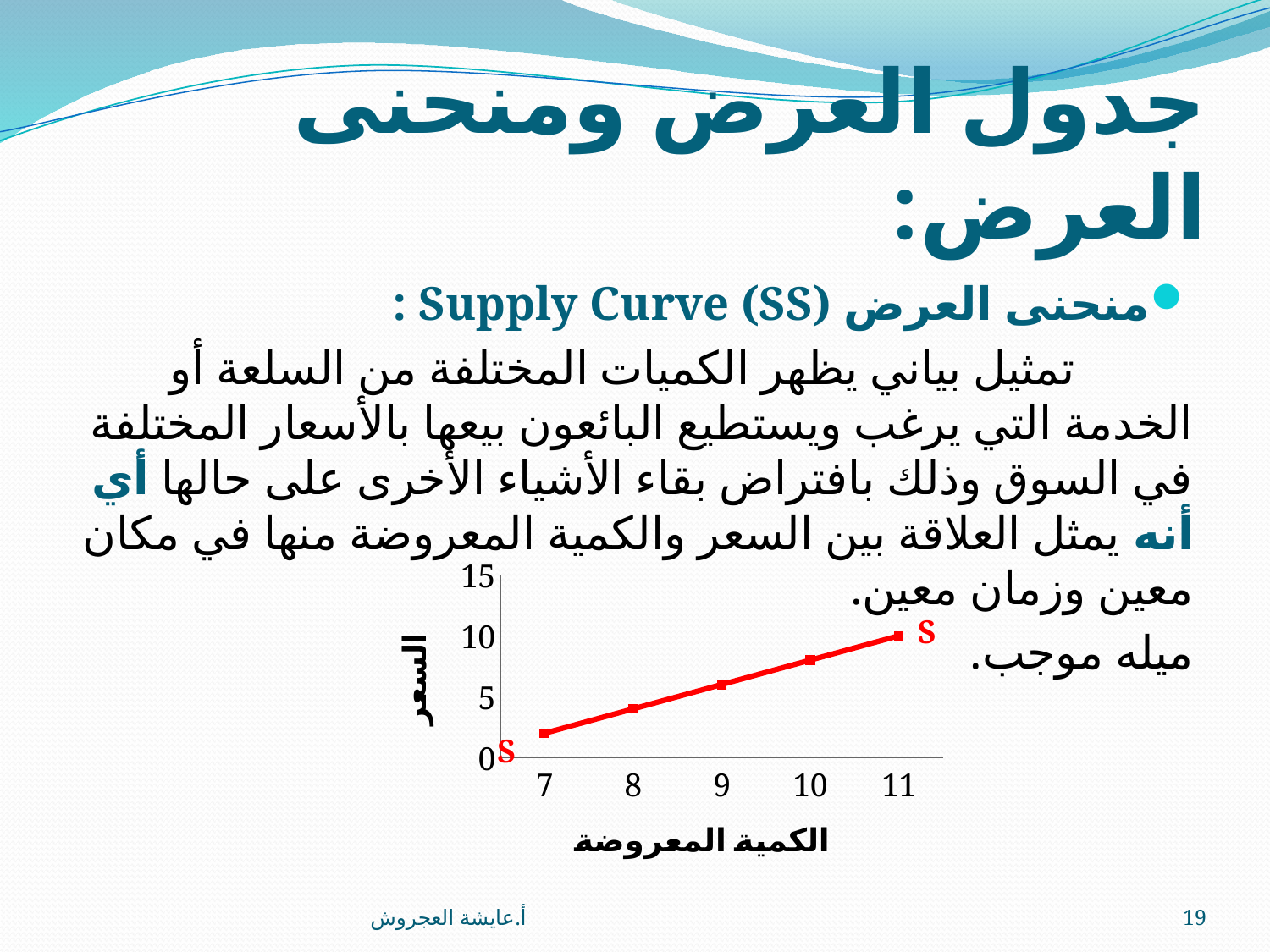
At which quantity supplied is the price highest? 11 What kind of chart is shown on the slide? line chart Is the price at quantity 7 greater or less than 5? less Is the price at quantity 10 greater or less than 10? less What is the title of the y axis? السعر Which has the higher price: quantity 8 or quantity 10? 10 What is the title of the x axis? الكمية المعروضة Is the price at quantity 9 greater or less than 5? greater How many data points are plotted on the line? 5 At which quantity supplied is the price lowest? 7 Do the values rise or fall as the quantity supplied increases along the x axis? rise